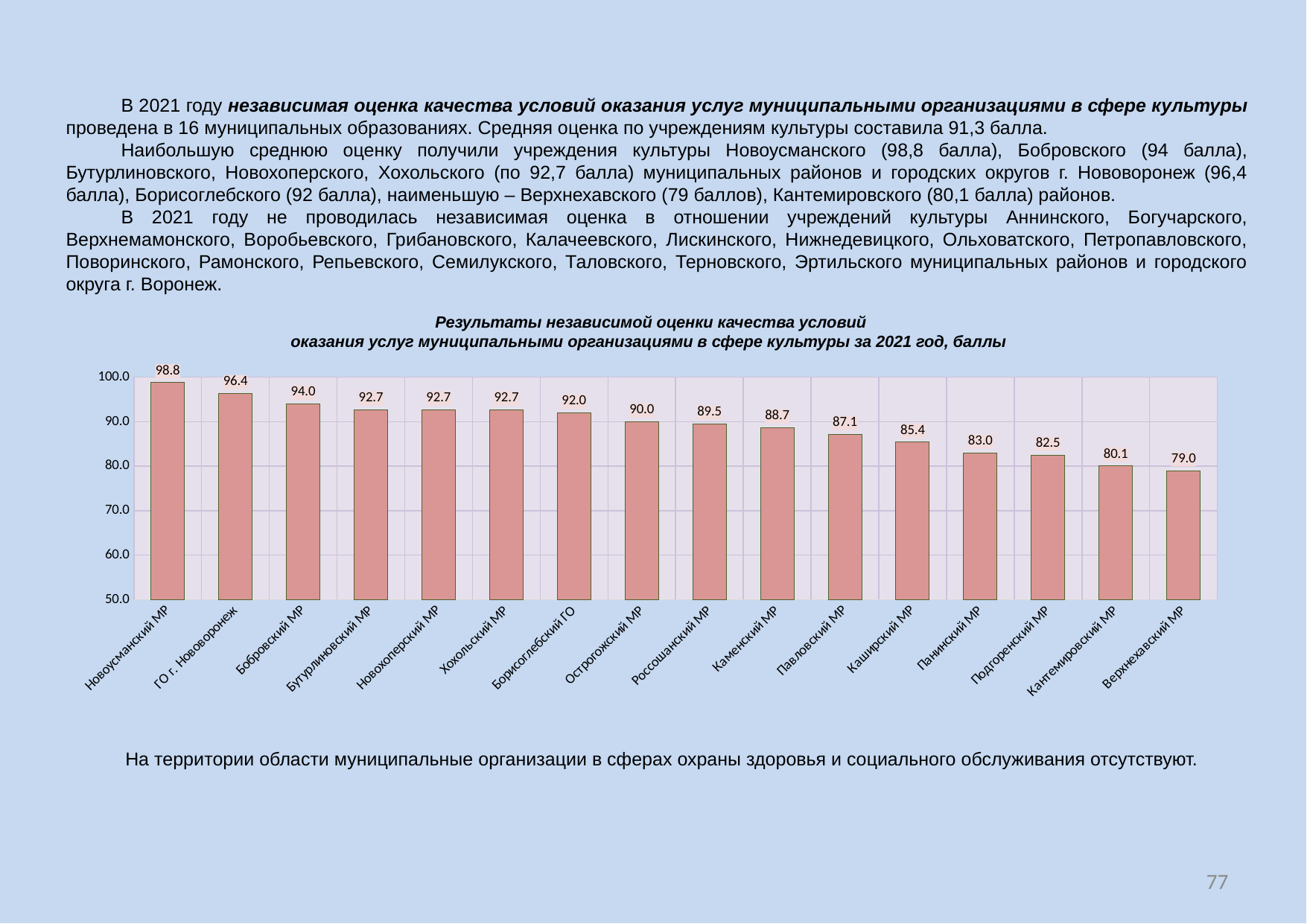
How many categories are shown on the x axis? 16 Which category has the highest value? Новоусманский МР What type of chart is shown on the slide? bar chart What is the value for Каширский МР? 85.4 What is the value for Кантемировский МР? 80.1 Which is larger, the value for Острогожский МР or the value for Павловский МР? Острогожский МР What is the value for Новоусманский МР? 98.8 Is the value for Панинский МР greater or less than 90.0? less What is the difference between the values for ГО г. Нововоронеж and Бобровский МР? 2.4 Which category has the lowest value? Верхнехавский МР Do the values rise or fall from left to right along the x axis? fall What is the difference between the values for Новоусманский МР and Верхнехавский МР? 19.8